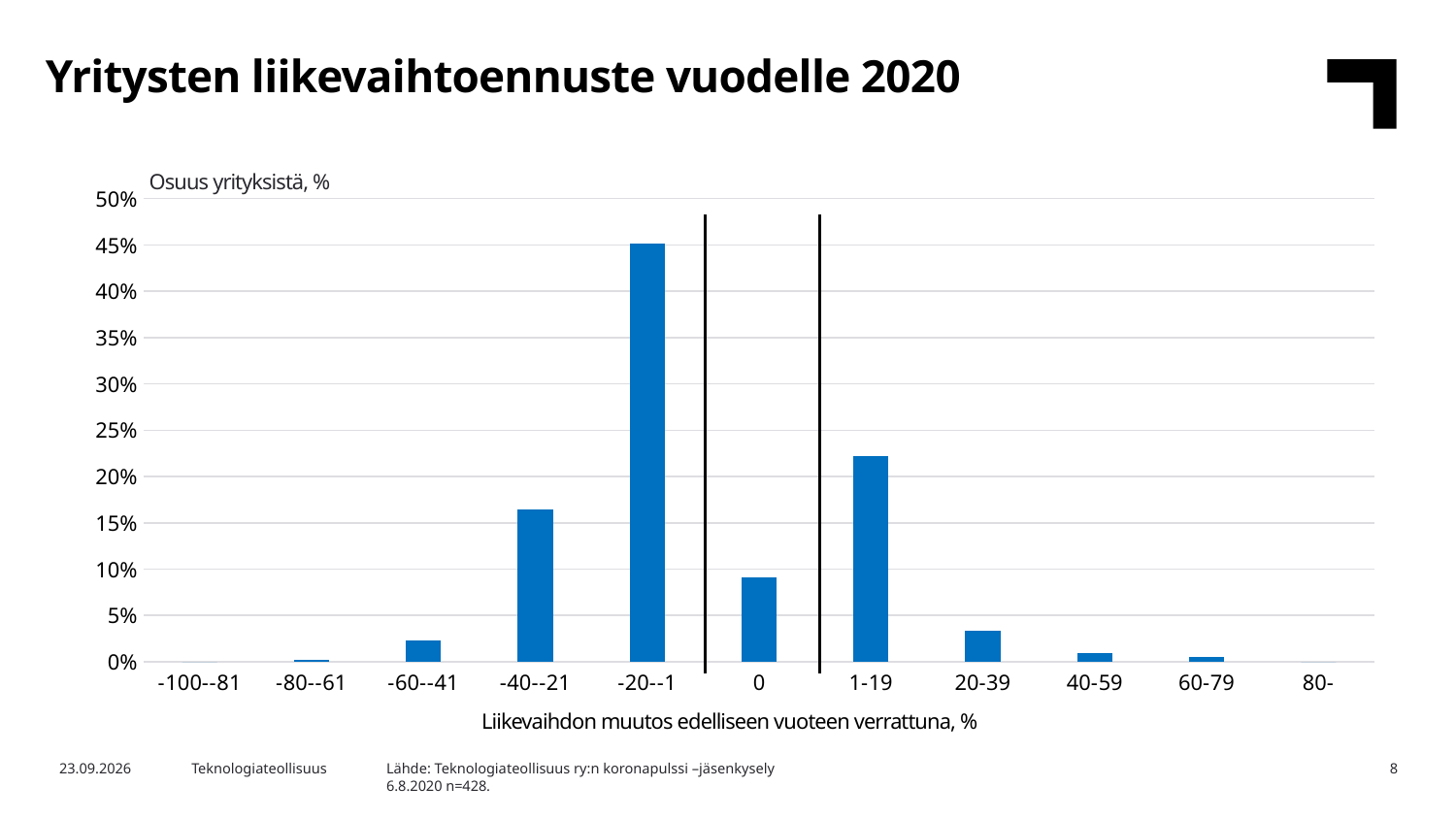
Is the value for -20--1 greater or less than 40%? greater What is the title of the chart on the slide? Yritysten liikevaihtoennuste vuodelle 2020 Which is larger, the value for -40--21 or the value for 1-19? 1-19 Which is larger, the value for 0 or the value for 20-39? 0 Which category has the highest share of companies? -20--1 Is the value for 0 greater or less than 10%? less Is the value for 20-39 greater or less than 5%? less What kind of chart is shown on the slide? bar chart What is the label of the horizontal axis? Liikevaihdon muutos edelliseen vuoteen verrattuna, % How many categories are shown on the horizontal axis? 11